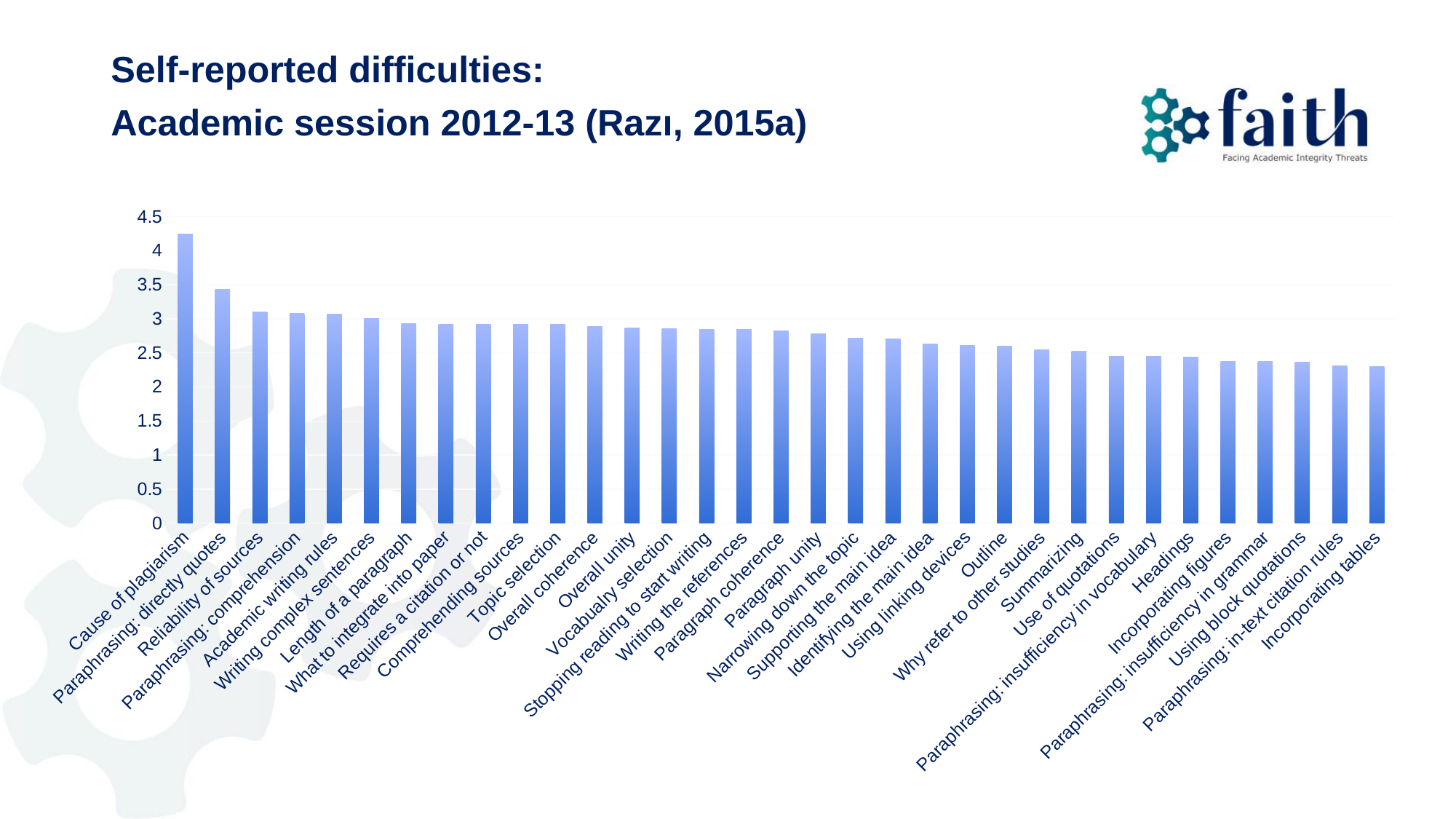
Is the value for Paraphrasing: directly quotes greater or less than 3? greater Is the value for Incorporating tables greater or less than 2.5? less Which is larger, the value for Cause of plagiarism or the value for Incorporating tables? Cause of plagiarism Which is larger, the value for Outline or the value for Paraphrasing: directly quotes? Paraphrasing: directly quotes Which category has the highest value? Cause of plagiarism Which category has the lowest value? Incorporating tables How many categories are plotted in the chart? 33 Is the value for Cause of plagiarism greater or less than 4? greater What kind of chart is shown on the slide? bar chart Do the values rise or fall from left to right along the x axis? fall